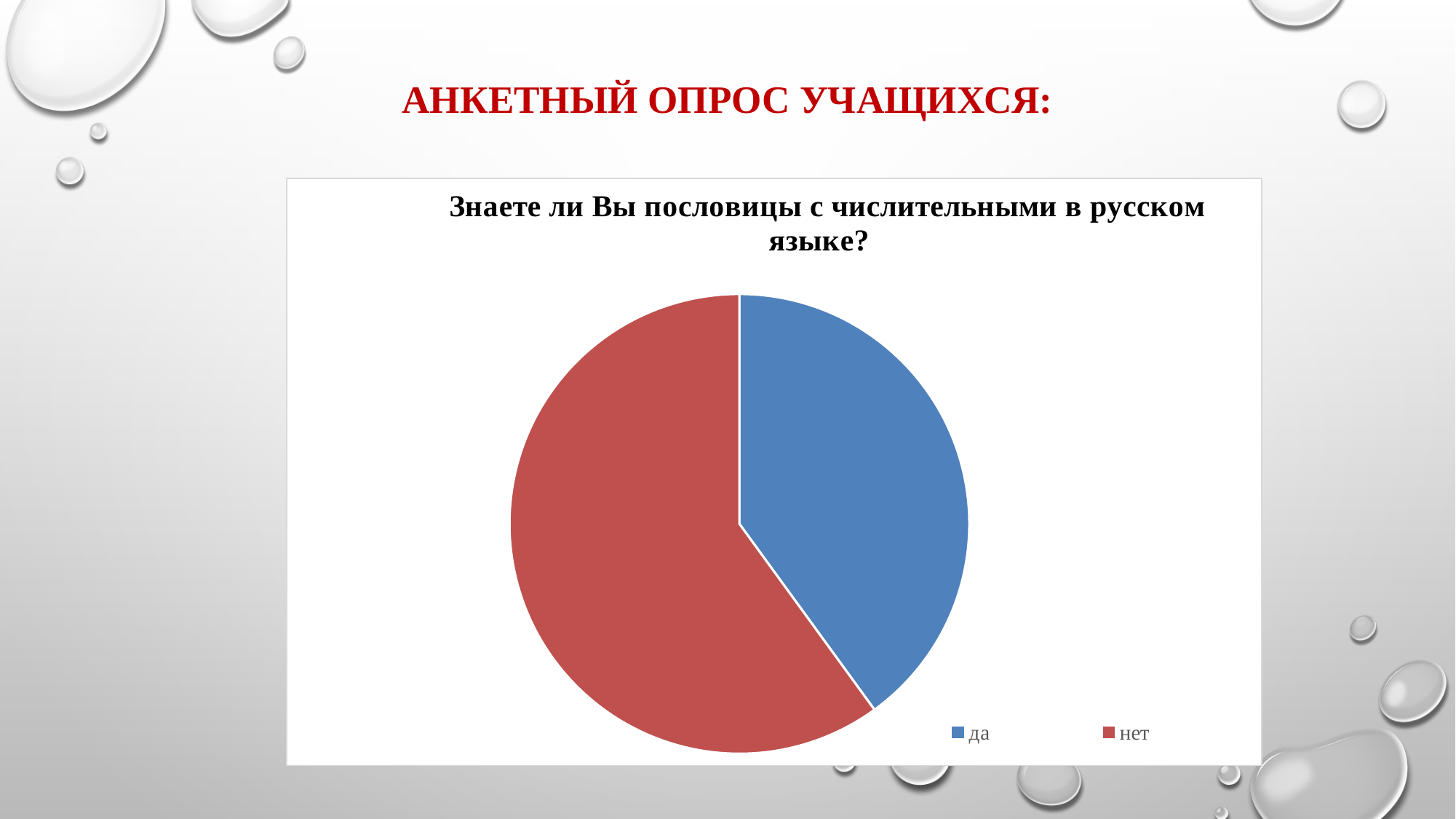
Does the "да" slice take up more or less than half of the pie chart? less How many slices does the pie chart have? 2 What is the title of the pie chart? Знаете ли Вы пословицы с числительными в русском языке? How many entries does the legend of the pie chart list? 2 What kind of chart is shown on the slide? pie chart What colour is the "нет" slice in the pie chart? red Which answer has the smallest slice in the pie chart? да Which slice is larger in the pie chart, "да" or "нет"? нет Which answer has the largest slice in the pie chart? нет